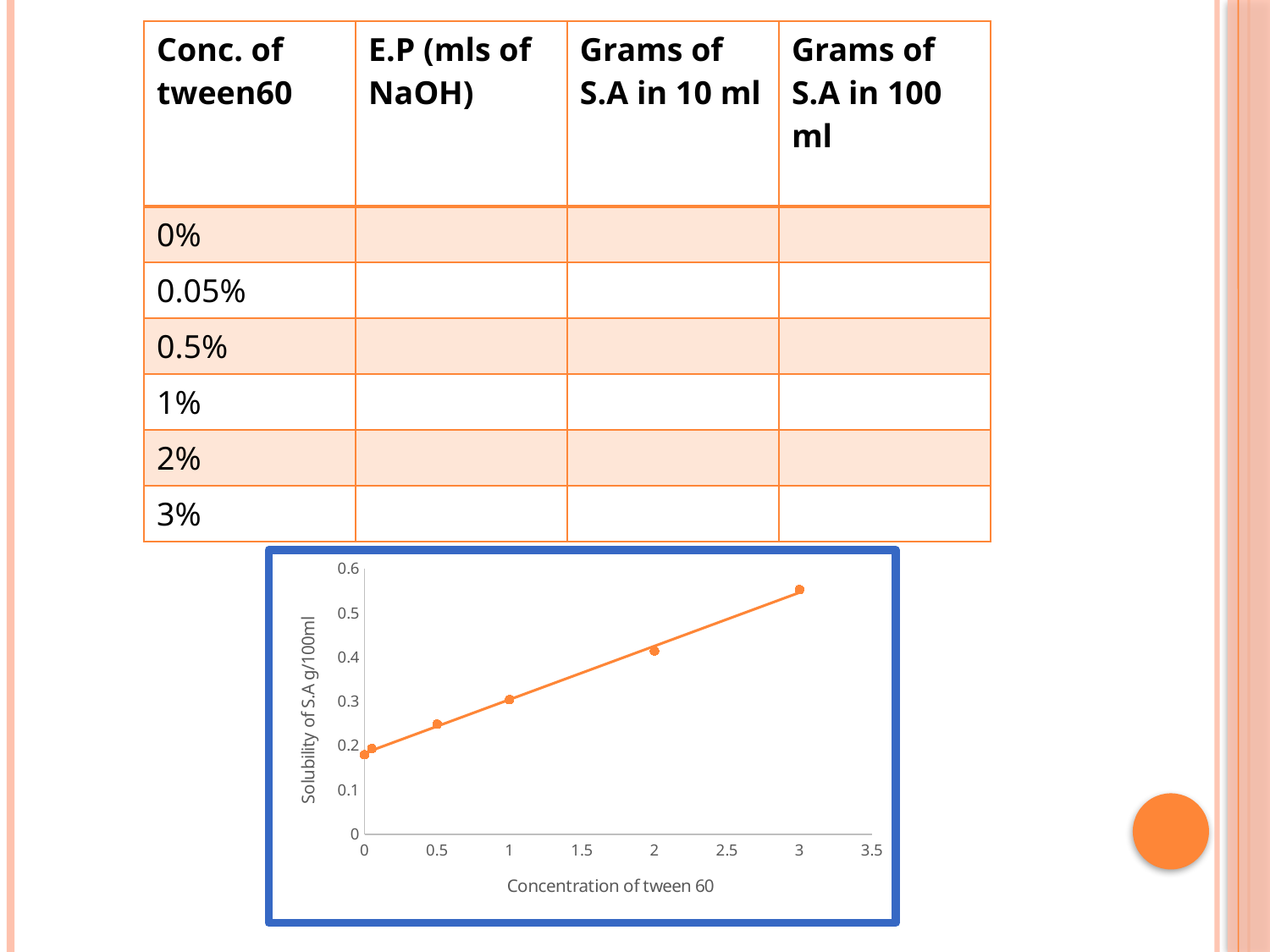
What is the title of the vertical axis of the chart? Solubility of S.A g/100ml Which has the larger solubility value: concentration 1 or concentration 2? concentration 2 What is the title of the horizontal axis of the chart? Concentration of tween 60 Is the solubility value at concentration 0 greater or less than 0.2? less At which concentration of tween 60 is the plotted solubility lowest? 0 Is the solubility value at concentration 3 greater or less than 0.5? greater Do the plotted solubility values rise or fall as the concentration of tween 60 increases? rise Is the solubility value at concentration 0.5 greater or less than 0.3? less At which concentration of tween 60 is the plotted solubility highest? 3 What kind of chart is shown on the slide? scatter chart How many data points are plotted on the chart? 6